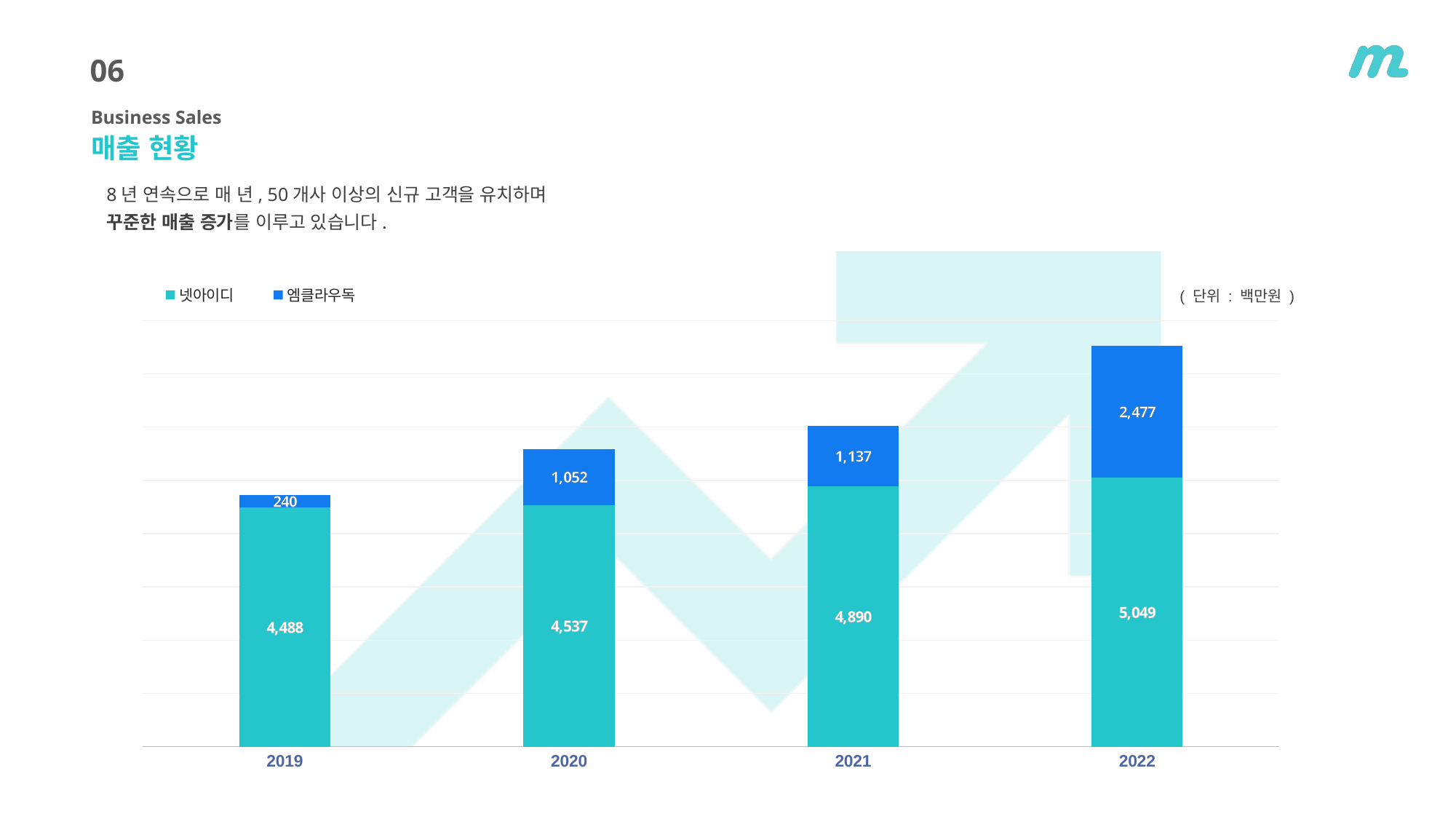
What kind of chart is shown on the slide? Stacked bar chart What is the total of the stacked bar for 2022? 7,526 How many series does the legend list? 2 What is the value for 넷아이디 in 2021? 4,890 In which year is the 넷아이디 value highest? 2022 Which is larger, the 엠클라우독 value in 2020 or in 2021? 2021 What is the value for 엠클라우독 in 2019? 240 What is the difference between the 엠클라우독 values for 2021 and 2020? 85 How many years are shown on the x axis? 4 In which year is the 엠클라우독 value lowest? 2019 What is the difference between the 넷아이디 values for 2022 and 2019? 561 What is the value for 엠클라우독 in 2022? 2,477